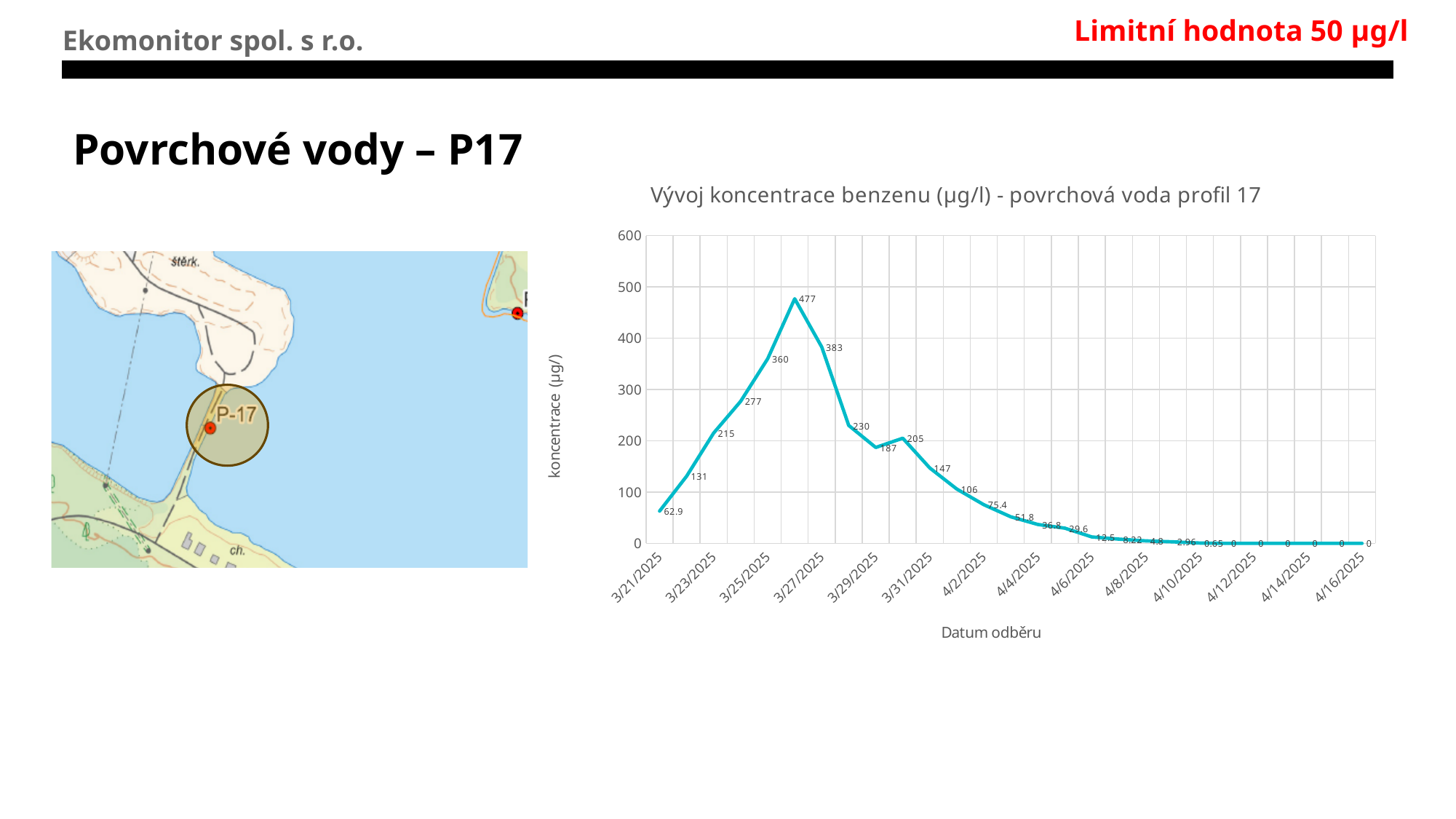
Is the benzene concentration on 3/29/2025 greater or less than 100? greater What is the benzene concentration on 3/21/2025? 62.9 What is the benzene concentration on 3/27/2025? 383 Does the benzene concentration rise or fall between 3/27/2025 and 4/16/2025? fall What is the benzene concentration on 4/2/2025? 75.4 What is the title of the chart? Vývoj koncentrace benzenu (µg/l) - povrchová voda profil 17 Which date has the higher benzene concentration, 3/25/2025 or 3/31/2025? 3/25/2025 What is the difference between the benzene concentration on 3/27/2025 (383) and on 3/23/2025 (215)? 168 What is the benzene concentration on 4/10/2025? 0.65 What is the highest benzene concentration value plotted on the chart? 477 What is the label of the y axis of the chart? koncentrace (µg/l) What kind of chart is shown on the slide? line chart